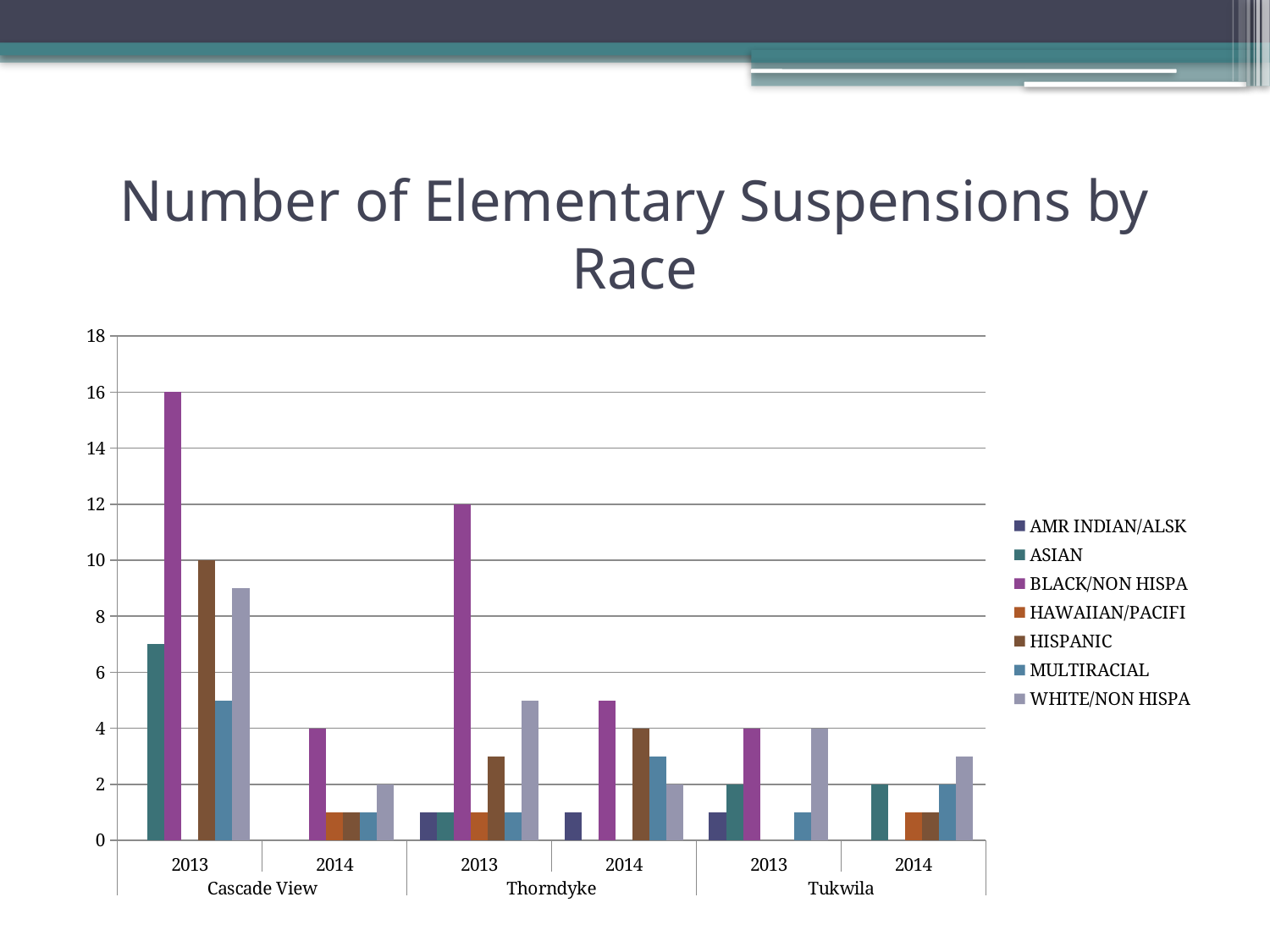
Is the value for WHITE/NON HISPA at Thorndyke in 2013 greater or less than 4? greater Is the value for ASIAN at Cascade View in 2013 greater or less than 6? greater What is the value for HISPANIC at Cascade View in 2013? 10 Which is larger at Thorndyke in 2014: BLACK/NON HISPA or WHITE/NON HISPA? BLACK/NON HISPA What type of chart is shown on the slide? bar chart Which series has the highest value at Cascade View in 2013? BLACK/NON HISPA How many series does the legend list? 7 What is the value for BLACK/NON HISPA at Tukwila in 2013? 4 What is the difference between the BLACK/NON HISPA values for Cascade View in 2013 and Thorndyke in 2013? 4 How many schools are shown along the x axis? 3 What is the value for BLACK/NON HISPA at Thorndyke in 2013? 12 What is the value for BLACK/NON HISPA at Cascade View in 2013? 16